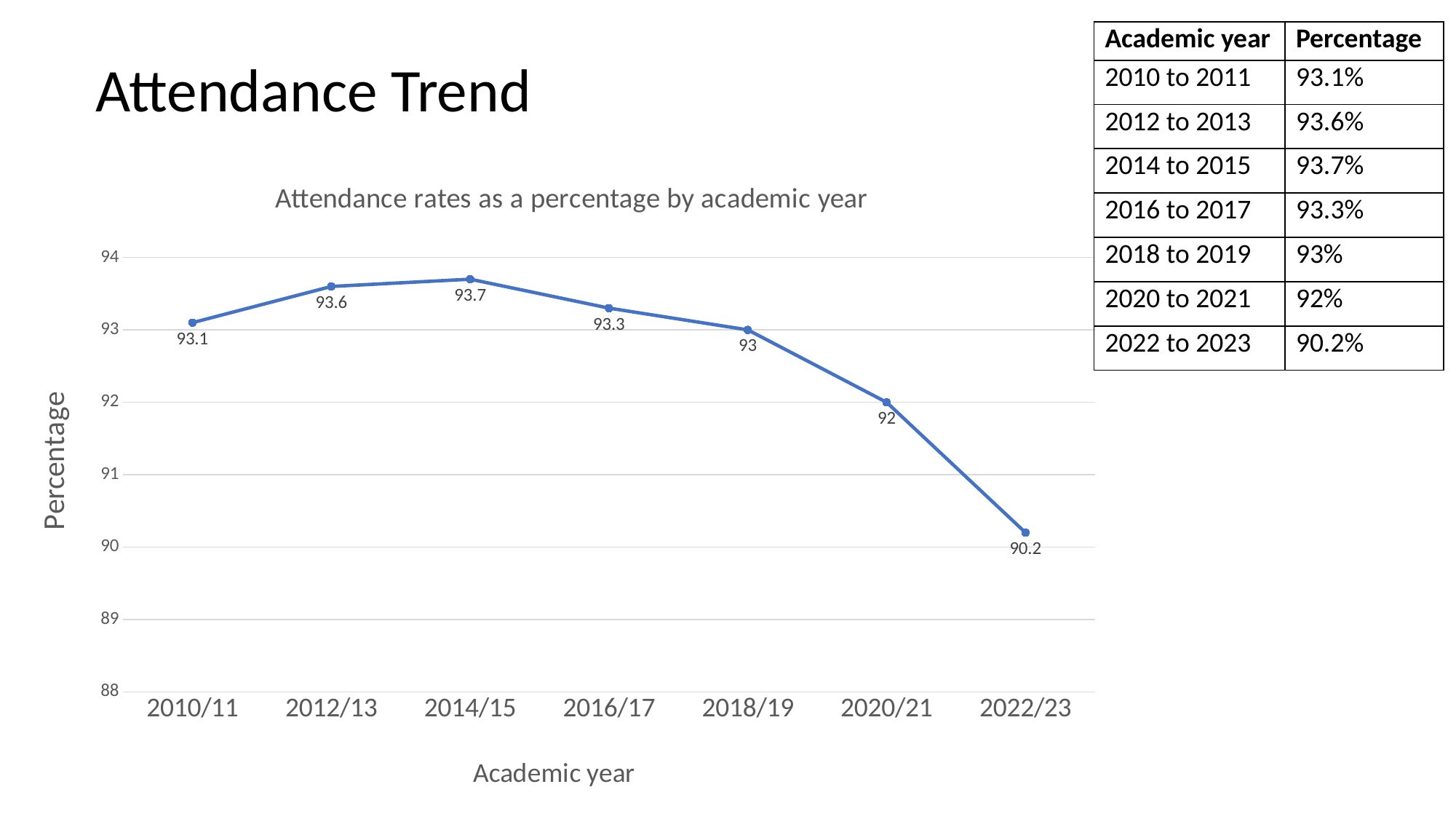
What is the difference between the attendance rates for 2014/15 and 2022/23? 3.5 Which has a higher attendance rate, 2010/11 or 2016/17? 2016/17 Is the value for 2020/21 greater or less than 93? less Which academic year has the lowest attendance rate? 2022/23 What kind of chart is shown on the slide? line chart How many academic years are plotted on the chart? 7 Do the attendance rates rise or fall from 2014/15 to 2022/23? fall What is the attendance rate for 2018/19? 93 What is the attendance rate for 2022/23? 90.2 What is the attendance rate for 2014/15? 93.7 Which academic year has the highest attendance rate? 2014/15 What is the difference between the attendance rates for 2020/21 and 2022/23? 1.8